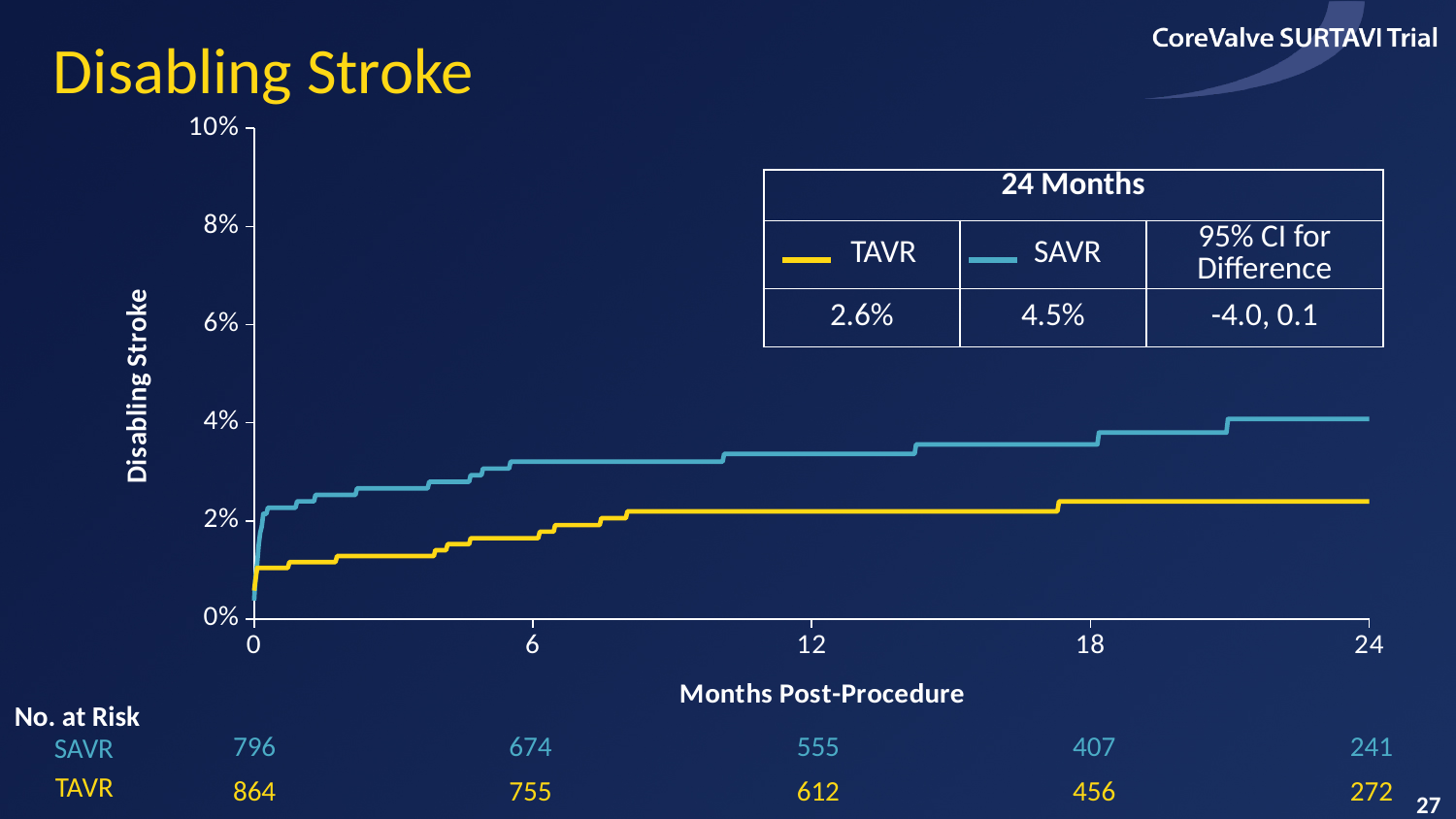
Do the disabling stroke curves rise or fall as months post-procedure increase? Rise What is the disabling stroke rate for SAVR at 24 months? 4.5% How many SAVR patients were at risk at 12 months? 555 What is the disabling stroke rate for TAVR at 24 months? 2.6% What is the 95% CI for the difference between TAVR and SAVR at 24 months? -4.0, 0.1 What is the difference between the SAVR and TAVR disabling stroke rates at 24 months? 1.9% What is the label of the x axis? Months Post-Procedure Which group has the higher disabling stroke rate at 24 months, TAVR or SAVR? SAVR Is the SAVR disabling stroke rate at 24 months greater or less than 4%? greater What type of chart is shown on the slide? Line chart How many TAVR patients were at risk at 0 months? 864 How many series are shown in the chart? 2